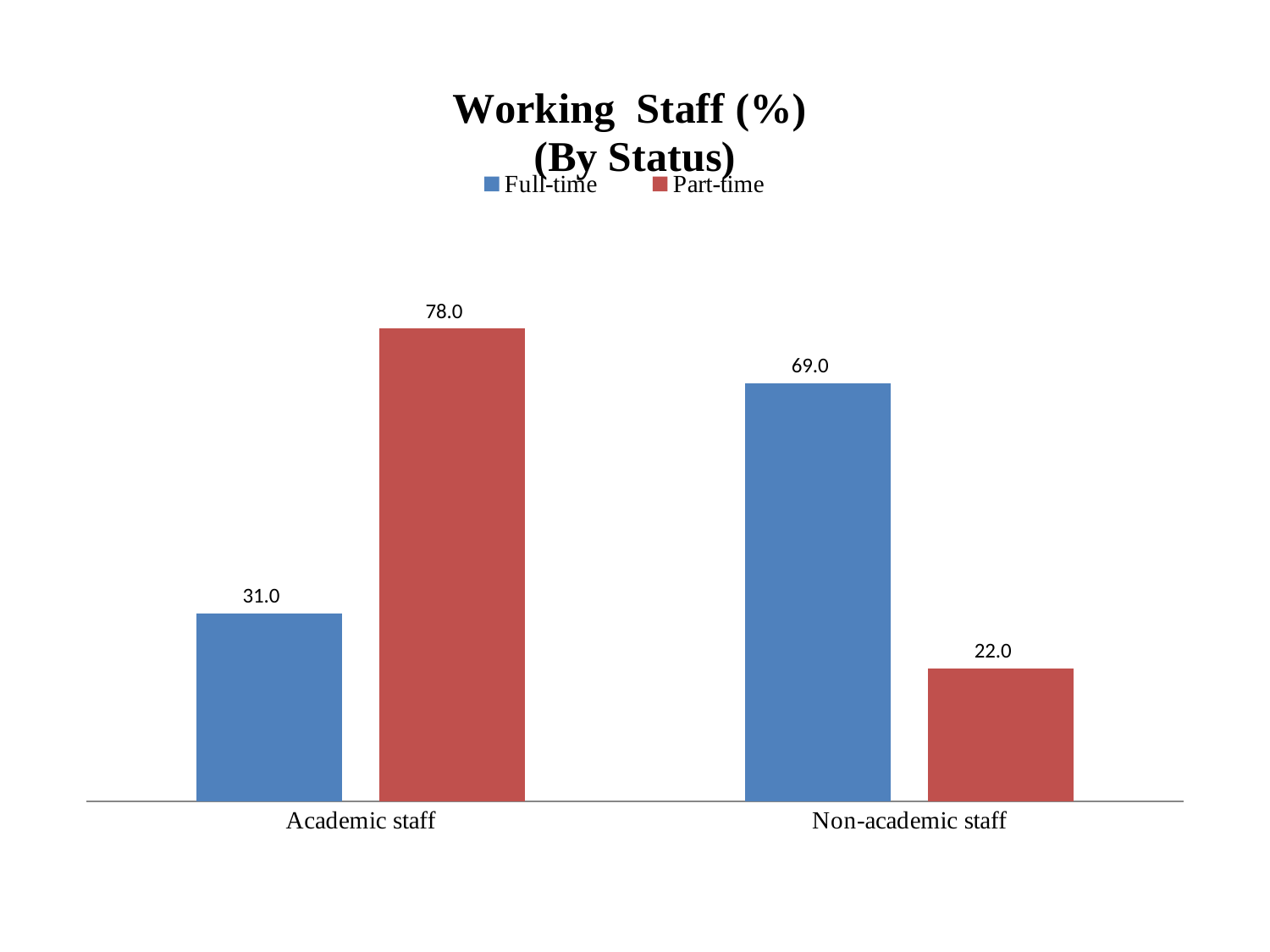
What is the Part-time value for Academic staff? 78.0 What is the Full-time value for Academic staff? 31.0 What is the difference between the Full-time values for Non-academic staff and Academic staff? 38.0 What is the Full-time value for Non-academic staff? 69.0 Which is larger for Non-academic staff, Full-time or Part-time? Full-time How many categories are shown on the x axis? 2 How many series does the legend list? 2 Which category has the lowest Full-time value? Academic staff What is the difference between the Part-time and Full-time values for Academic staff? 47.0 What is the Part-time value for Non-academic staff? 22.0 What kind of chart is shown on the slide? Bar chart Which category has the highest Part-time value? Academic staff